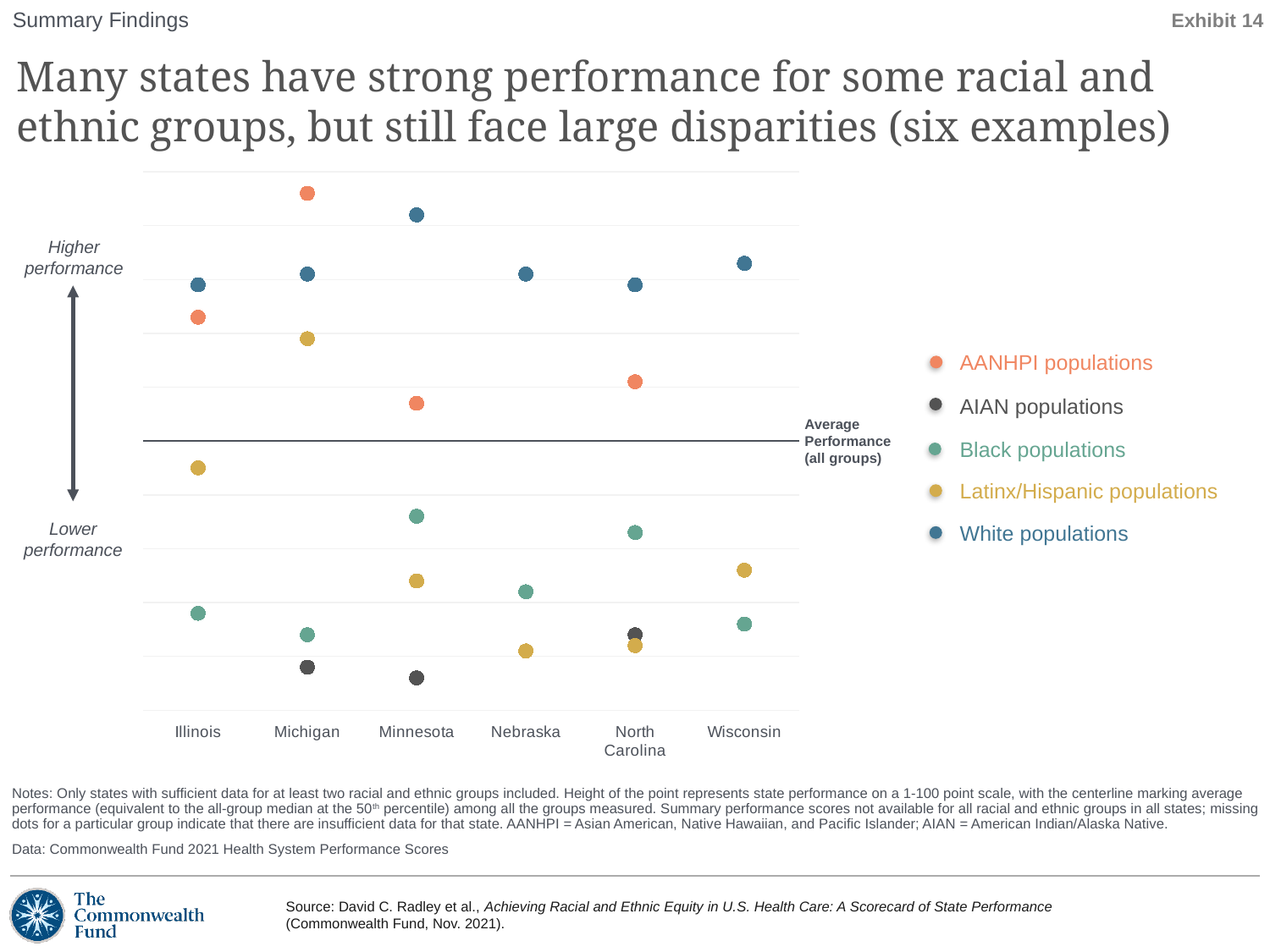
How many states are shown along the x axis of the chart? 6 Which population group has the highest performance point for Michigan? AANHPI populations In North Carolina, which is higher: the point for AANHPI populations or the point for Latinx/Hispanic populations? AANHPI populations What does the horizontal centerline on the chart represent? Average Performance (all groups) Is the point for AANHPI populations in Minnesota above or below the Average Performance (all groups) line? Above Is the point for Latinx/Hispanic populations in Illinois above or below the Average Performance (all groups) line? Below What kind of chart is shown on the slide? Dot plot Which population group has the lowest performance point for Minnesota? AIAN populations Which population group has the lowest performance point for Wisconsin? Black populations Which state has the single highest point on the chart? Michigan How many population groups does the chart's legend list? 5